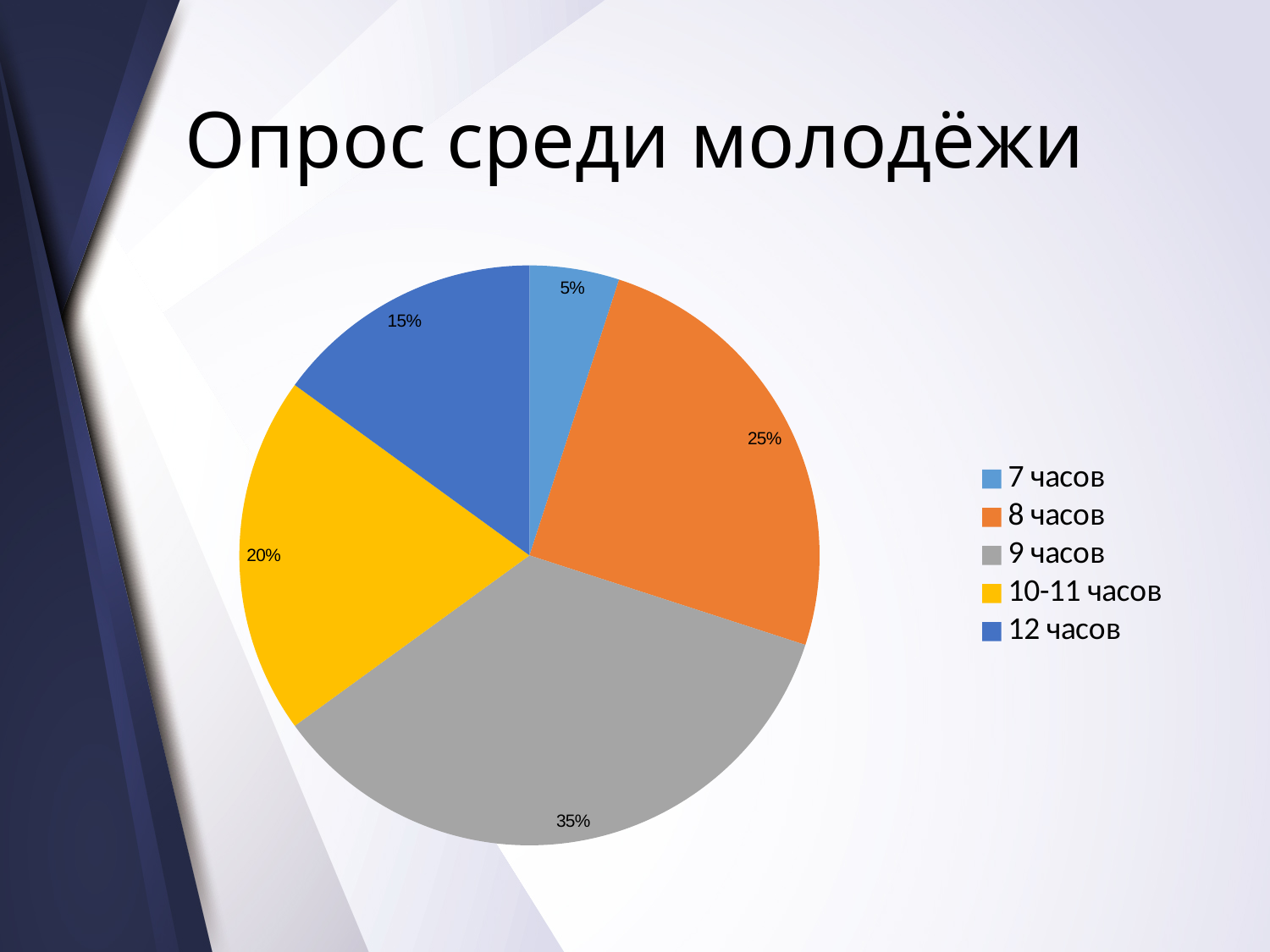
Which is larger, the "10-11 часов" slice or the "12 часов" slice? 10-11 часов What is the value for "10-11 часов"? 20% What share of the pie does the "7 часов" slice have? 5% What is the difference between the "9 часов" and "8 часов" slices? 10% What is the value for "12 часов"? 15% What share of the pie does the "9 часов" slice have? 35% Which category has the smallest slice? 7 часов What is the value for "8 часов"? 25% What is the title of the slide containing the chart? Опрос среди молодёжи Which category has the largest slice? 9 часов What kind of chart is shown on the slide? pie chart How many categories does the legend list? 5